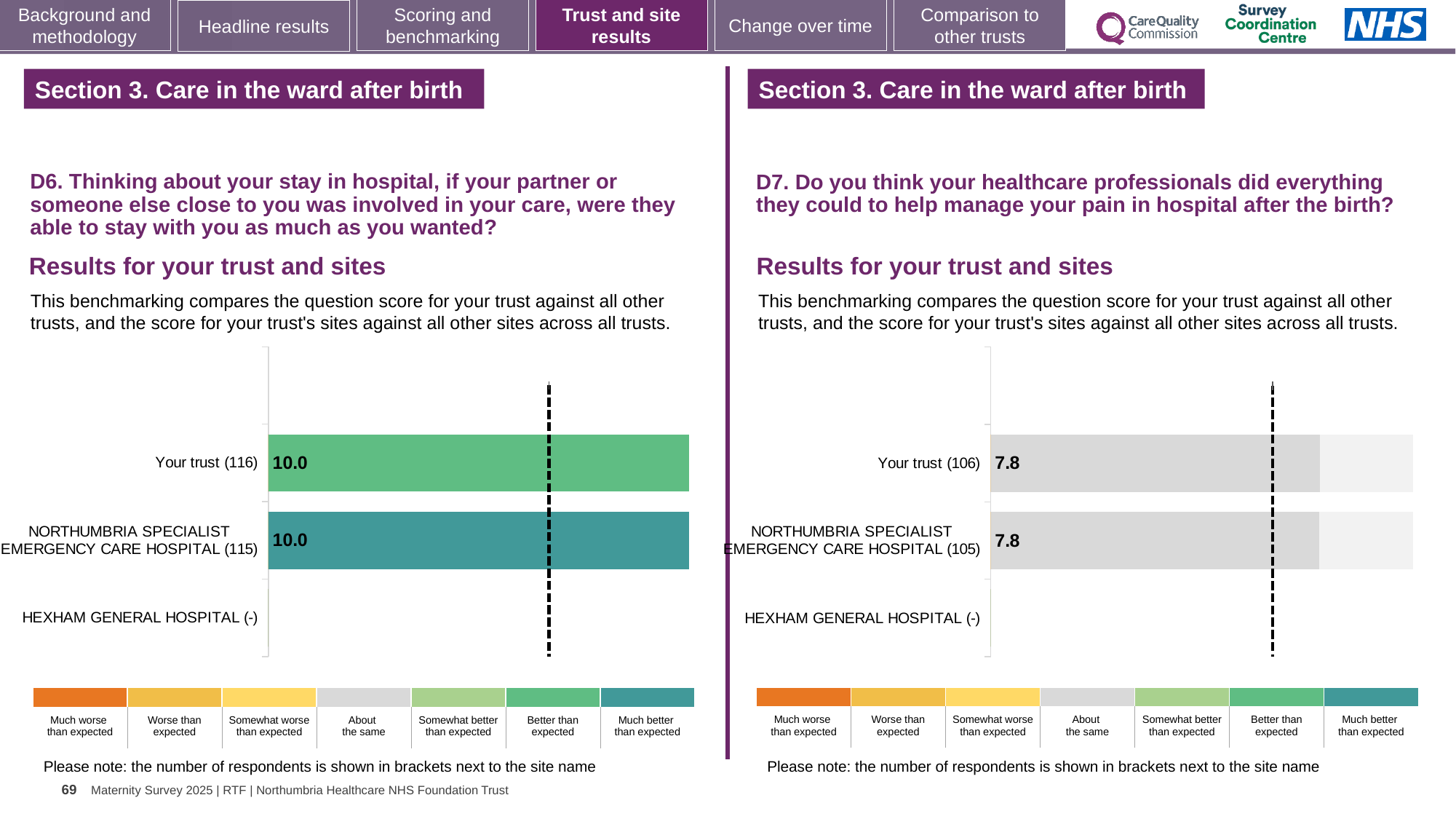
On the left chart (D6), what is the difference between the score for Your trust and the score for NORTHUMBRIA SPECIALIST EMERGENCY CARE HOSPITAL? 0.0 On the right chart (D7), what is the score for Your trust (106)? 7.8 On the right chart (D7), what is the difference between the score for Your trust and the score for NORTHUMBRIA SPECIALIST EMERGENCY CARE HOSPITAL? 0.0 On the right chart (D7), what is the score for NORTHUMBRIA SPECIALIST EMERGENCY CARE HOSPITAL (105)? 7.8 On the left chart (D6), what is the score for NORTHUMBRIA SPECIALIST EMERGENCY CARE HOSPITAL (115)? 10.0 What type of chart is used on the right (D7)? Bar chart On the left chart (D6), how many respondents are shown in brackets for Your trust? 116 How many categories (rows) are listed on the right chart (D7)? 3 On the right chart (D7), which site has no score shown (marked with a dash)? HEXHAM GENERAL HOSPITAL (-) How many categories (rows) are listed on the left chart (D6)? 3 What type of chart is used on the left (D6)? Bar chart On the left chart (D6), what is the score for Your trust (116)? 10.0